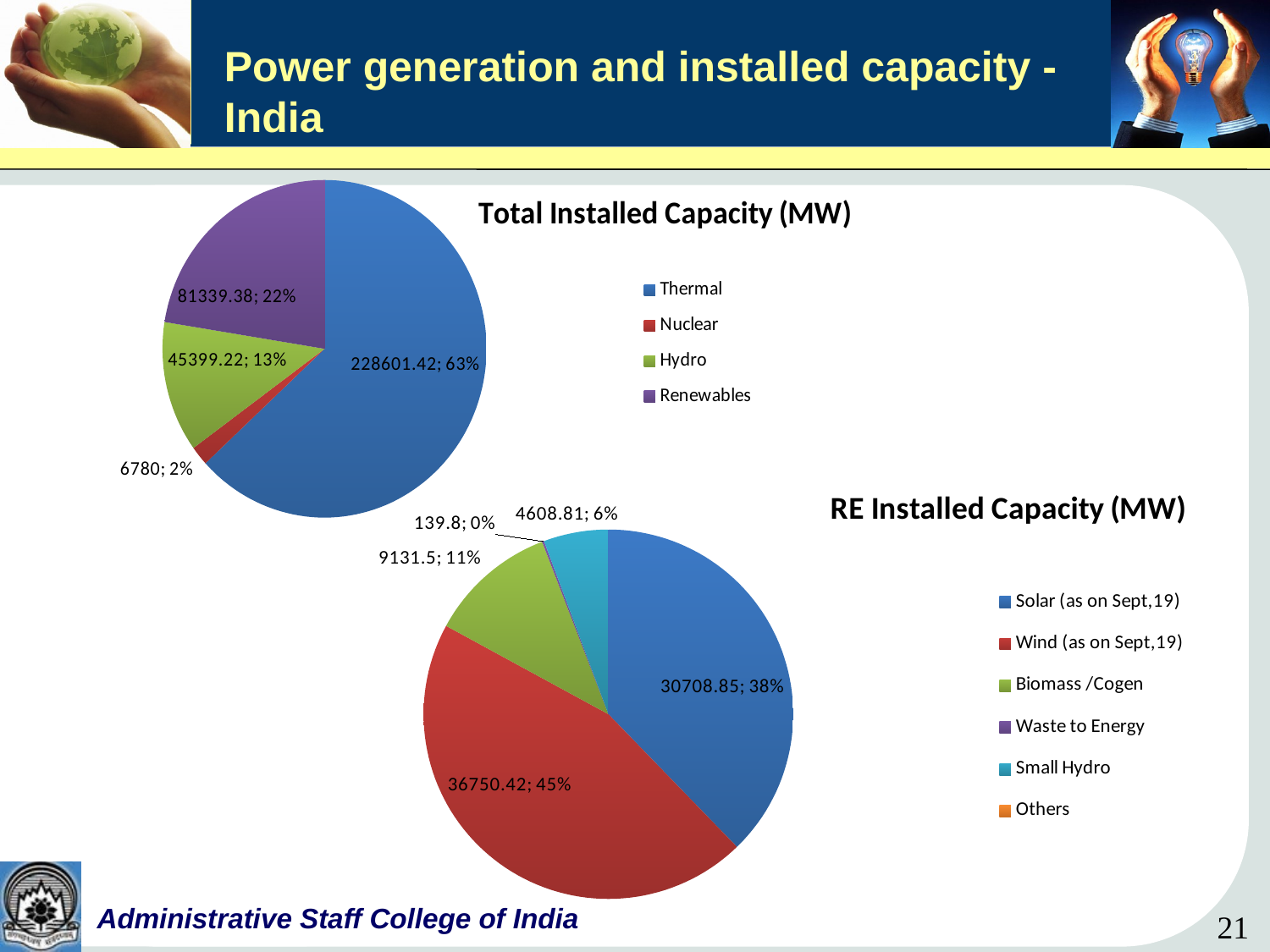
In the RE Installed Capacity (MW) chart, what is the value for Wind (as on Sept,19)? 36750.42 In the RE Installed Capacity (MW) chart, how many entries does the legend list? 6 In the Total Installed Capacity (MW) chart, what is the value for Hydro? 45399.22 In the Total Installed Capacity (MW) chart, which category has the largest value? Thermal In the RE Installed Capacity (MW) chart, what is the difference between the Wind (as on Sept,19) and Solar (as on Sept,19) values? 6041.57 In the Total Installed Capacity (MW) chart, what share of the pie does Renewables represent? 22% In the Total Installed Capacity (MW) chart, what is the value for Thermal? 228601.42 In the Total Installed Capacity (MW) chart, which category has the smallest value? Nuclear What type of chart is used for RE Installed Capacity (MW)? Pie chart In the RE Installed Capacity (MW) chart, what share of the pie does Solar (as on Sept,19) represent? 38% In the Total Installed Capacity (MW) chart, how many categories does the legend list? 4 In the RE Installed Capacity (MW) chart, which is larger, Wind (as on Sept,19) or Solar (as on Sept,19)? Wind (as on Sept,19)